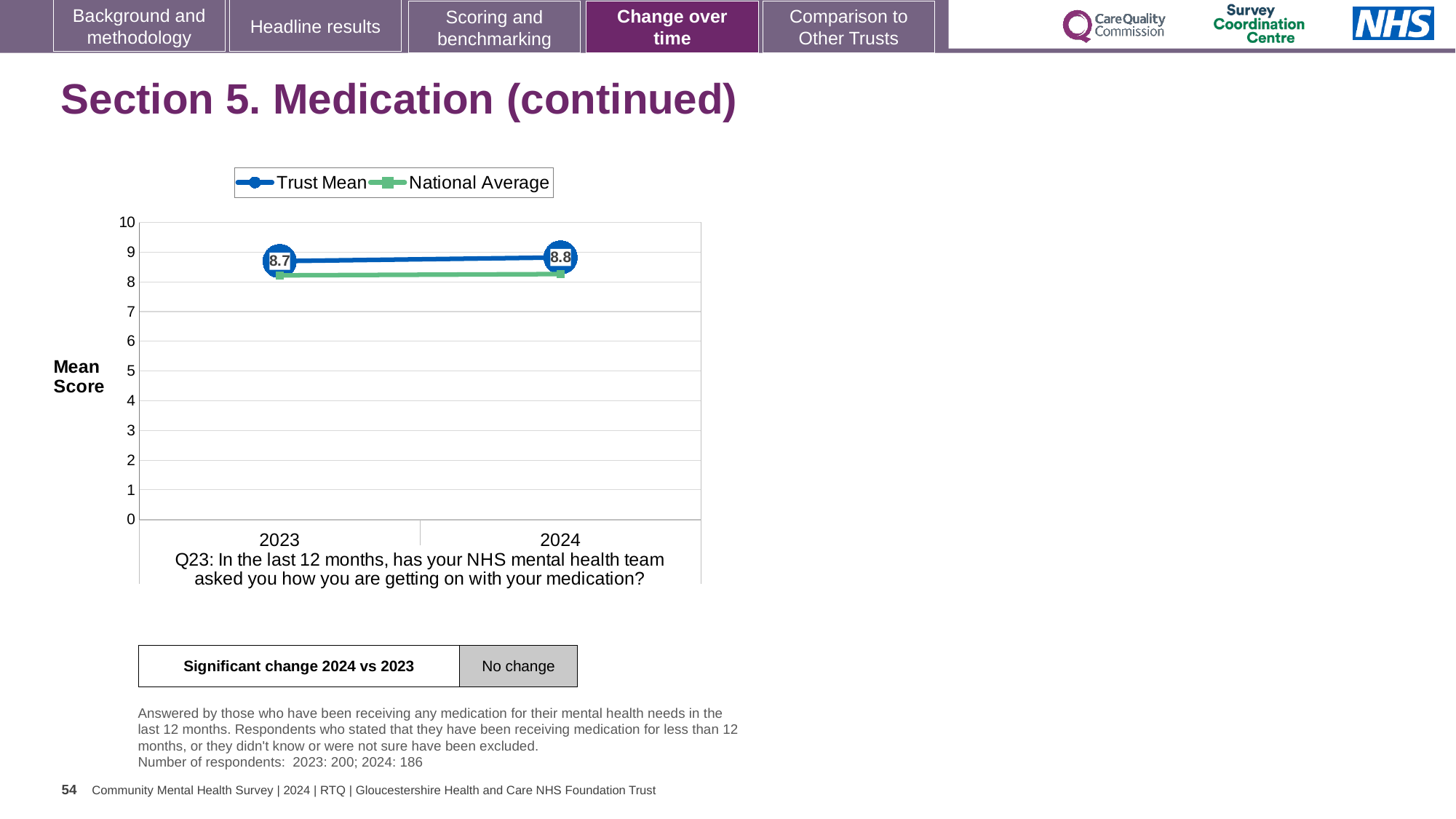
What kind of chart is shown on the slide? Line chart Is the National Average value for 2023 greater or less than 8? greater What is the Trust Mean value for 2023? 8.7 Is the National Average value for 2024 greater or less than 9? less How many series does the chart legend list? 2 In 2024, which series is higher, Trust Mean or National Average? Trust Mean What is the Trust Mean value for 2024? 8.8 By how much did the Trust Mean change from 2023 to 2024? 0.1 How many years are shown on the x axis of the chart? 2 Which year has the higher Trust Mean, 2023 or 2024? 2024 What is the label on the y axis of the chart? Mean Score Does the Trust Mean rise or fall from 2023 to 2024? Rise